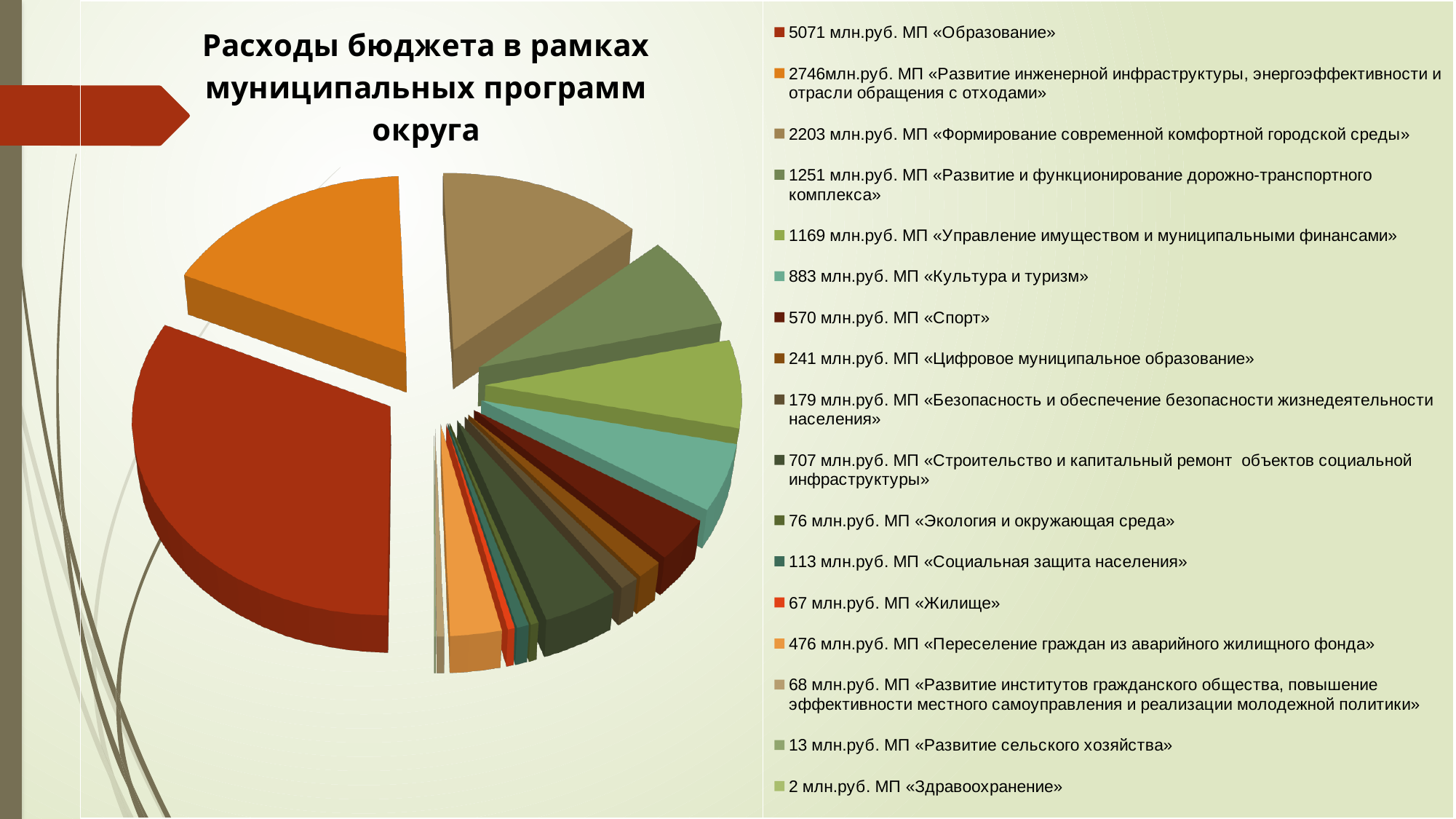
What is the value for МП «Спорт»? 570 млн.руб. What is the difference between the values for МП «Образование» and МП «Развитие инженерной инфраструктуры, энергоэффективности и отрасли обращения с отходами»? 2325 млн.руб. What is the value for МП «Переселение граждан из аварийного жилищного фонда»? 476 млн.руб. What is the value for МП «Образование»? 5071 млн.руб. Which is larger: the value for МП «Формирование современной комфортной городской среды» or МП «Развитие и функционирование дорожно-транспортного комплекса»? МП «Формирование современной комфортной городской среды» What is the title of the chart? Расходы бюджета в рамках муниципальных программ округа Which municipal programme has the largest expenditure? МП «Образование» What kind of chart is shown on the slide? Pie chart What is the value for МП «Культура и туризм»? 883 млн.руб. How many municipal programmes (slices) does the legend list? 17 What is the difference between the values for МП «Социальная защита населения» and МП «Жилище»? 46 млн.руб. Which municipal programme has the smallest expenditure? МП «Здравоохранение»